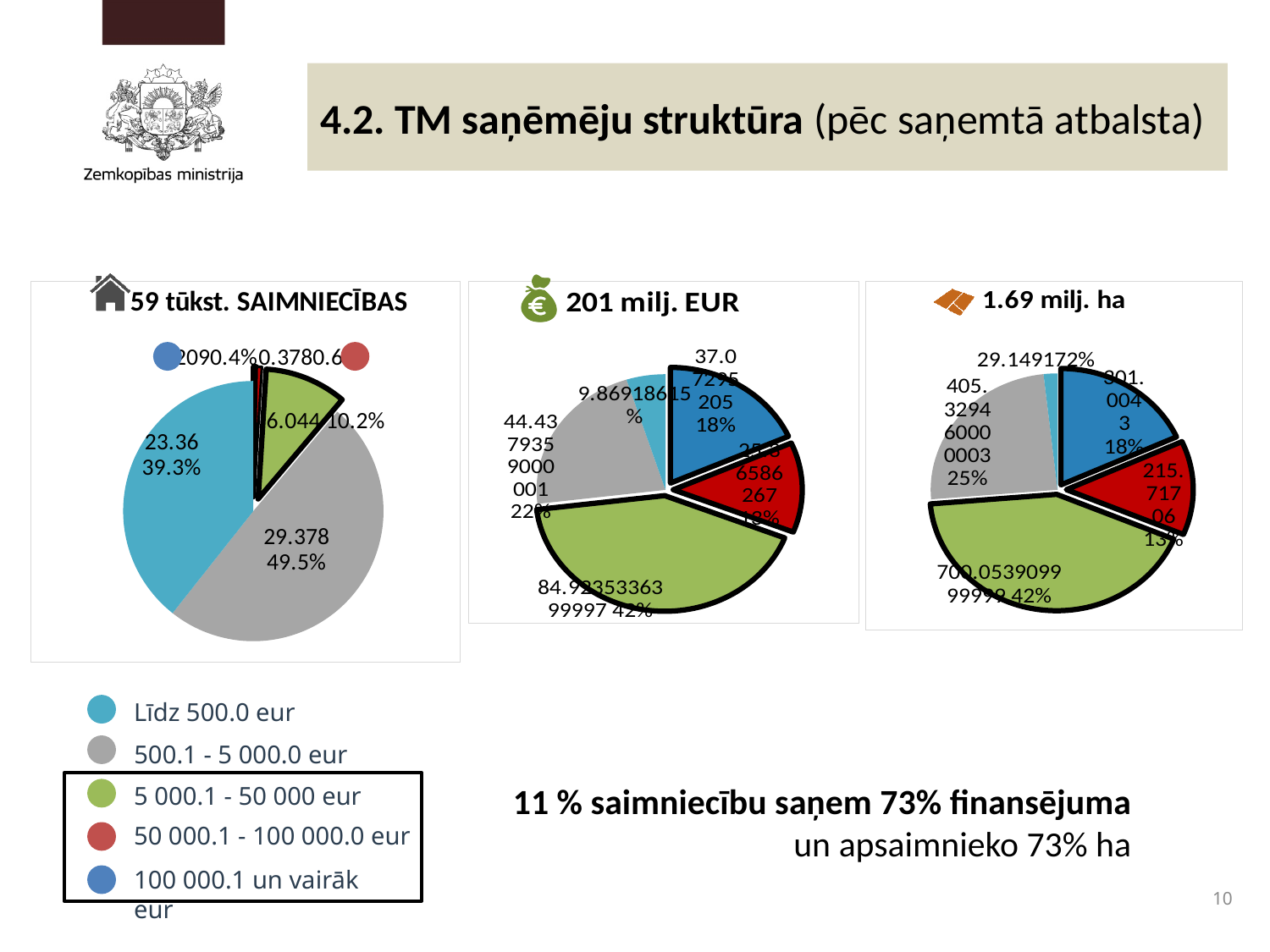
In the '59 tūkst. SAIMNIECĪBAS' chart, what is the difference in percentage points between the '500.1 - 5 000.0 eur' and 'Līdz 500.0 eur' slices? 10.2 percentage points In the '201 milj. EUR' chart, which category has the largest slice? 5 000.1 - 50 000 eur In the '59 tūkst. SAIMNIECĪBAS' chart, which category has the largest slice? 500.1 - 5 000.0 eur In the '201 milj. EUR' chart, what share does the '100 000.1 un vairāk eur' category have? 18% In the '201 milj. EUR' chart, what share does the '5 000.1 - 50 000 eur' category have? 42% In the '59 tūkst. SAIMNIECĪBAS' chart, what share does the '5 000.1 - 50 000 eur' category have? 10.2% How many categories does the legend on the slide list? 5 In the '1.69 milj. ha' chart, which category has the smallest slice? Līdz 500.0 eur What kind of chart is used on this slide for the three charts? Pie chart